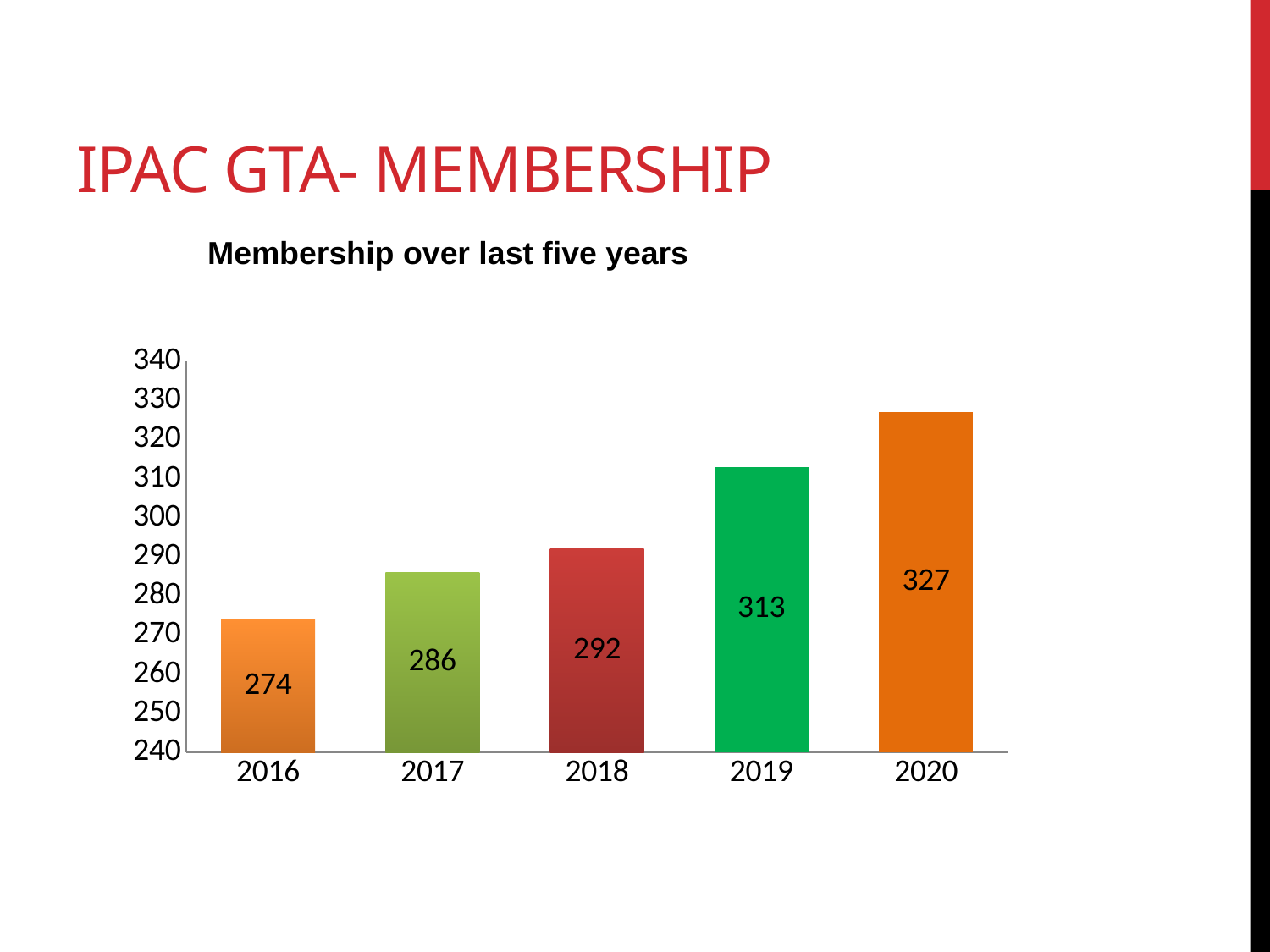
Which year had the highest membership? 2020 What type of chart is shown on the slide? Bar chart What was the membership in 2016? 274 How many years are shown on the chart? 5 Which year had higher membership, 2017 or 2019? 2019 Is the membership for 2019 greater or less than 300? greater Does membership rise or fall from 2016 to 2020? Rise What was the membership in 2018? 292 What was the membership in 2020? 327 What is the difference in membership between 2019 and 2018? 21 Which year had the lowest membership? 2016 By how much did membership increase from 2016 to 2020? 53